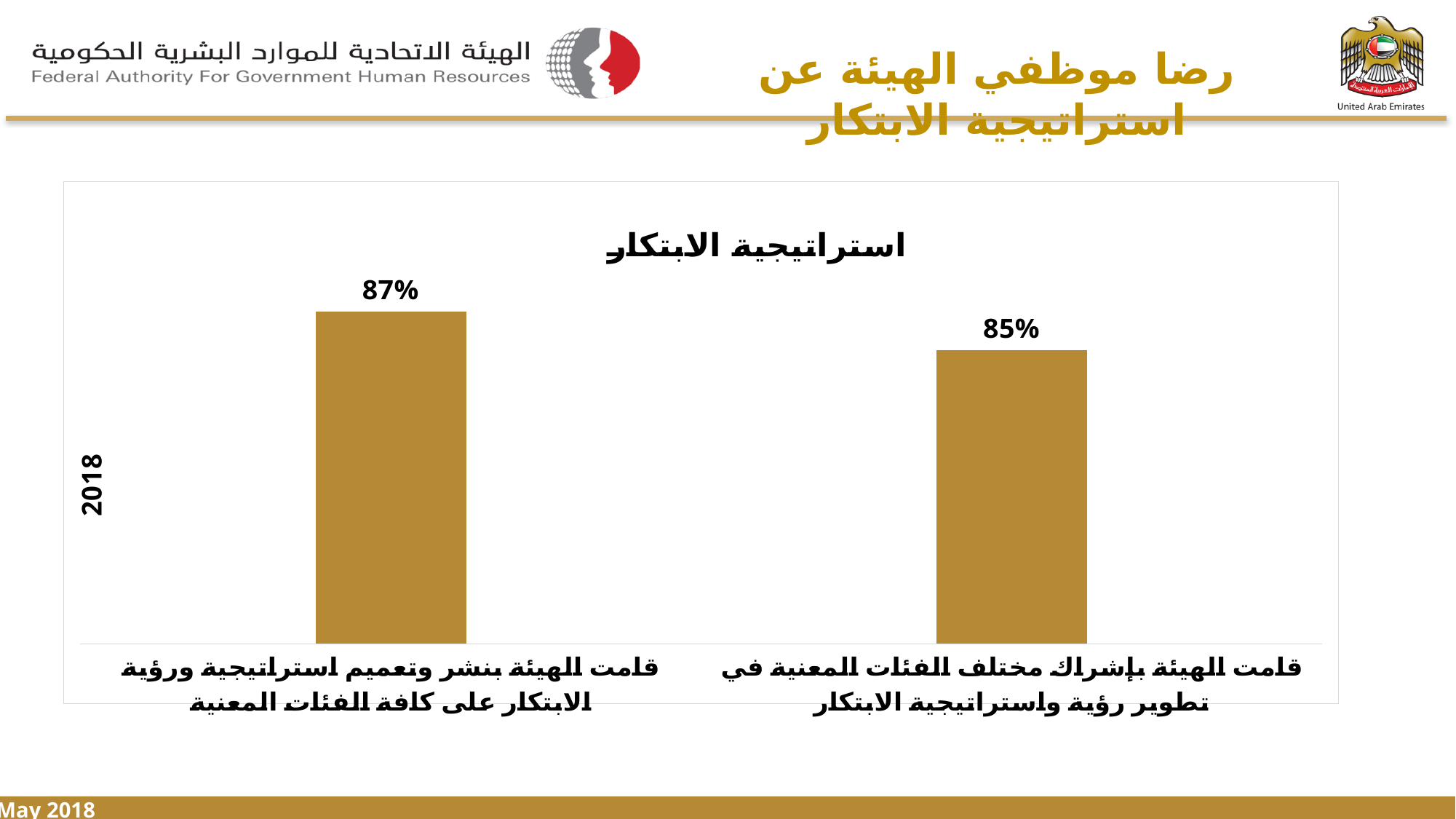
What is the value for the category "قامت الهيئة بإشراك مختلف الفئات المعنية في تطوير رؤية واستراتيجية الابتكار"? 85% How many bars are plotted in the chart? 2 Which is larger: the value for the left bar or the value for the right bar? The left bar (87%) What is the value for the category "قامت الهيئة بنشر وتعميم استراتيجية ورؤية الابتكار على كافة الفئات المعنية"? 87% What value is shown on the right bar of the chart? 85% Which category has the lowest value? قامت الهيئة بإشراك مختلف الفئات المعنية في تطوير رؤية واستراتيجية الابتكار What value is shown on the left bar of the chart? 87% What label appears on the vertical axis of the chart? 2018 What type of chart is shown on the slide? Bar chart What is the title of the chart? استراتيجية الابتكار Which category has the highest value? قامت الهيئة بنشر وتعميم استراتيجية ورؤية الابتكار على كافة الفئات المعنية What is the difference between the two bar values in the chart? 2%